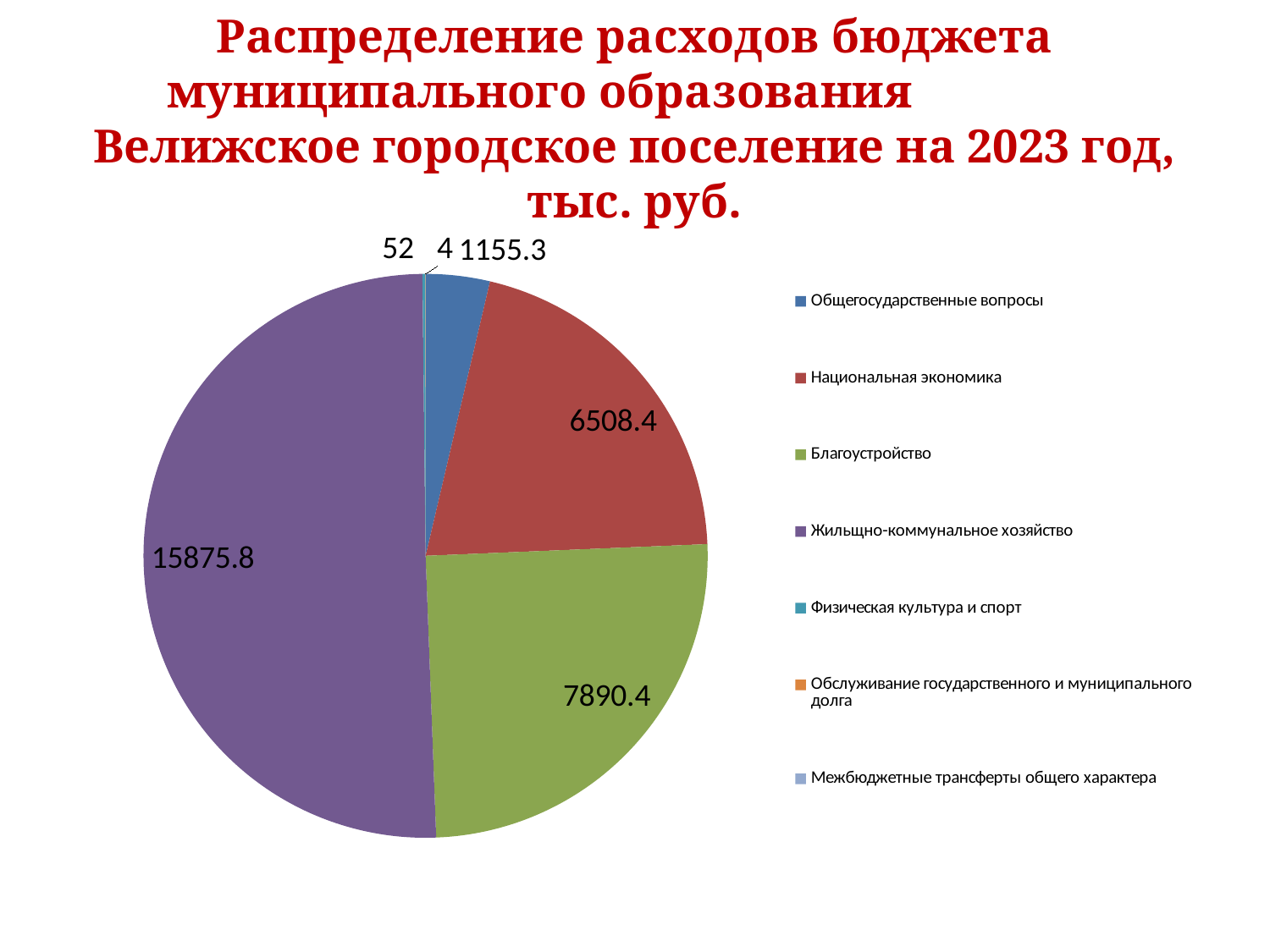
Which category has the largest slice of the pie? Жилищно-коммунальное хозяйство What is the difference between the values for Жилищно-коммунальное хозяйство and Благоустройство? 7985.4 What is the value for Общегосударственные вопросы? 1155.3 What is the value for Жилищно-коммунальное хозяйство? 15875.8 How many categories does the legend list? 7 What kind of chart is shown on the slide? pie chart What is the value for Благоустройство? 7890.4 Which is larger, Благоустройство or Национальная экономика? Благоустройство In what units are the values on the chart given, according to the title? тыс. руб. What colour is the slice for Жилищно-коммунальное хозяйство? purple What is the difference between the values for Благоустройство and Национальная экономика? 1382 What is the value for Национальная экономика? 6508.4